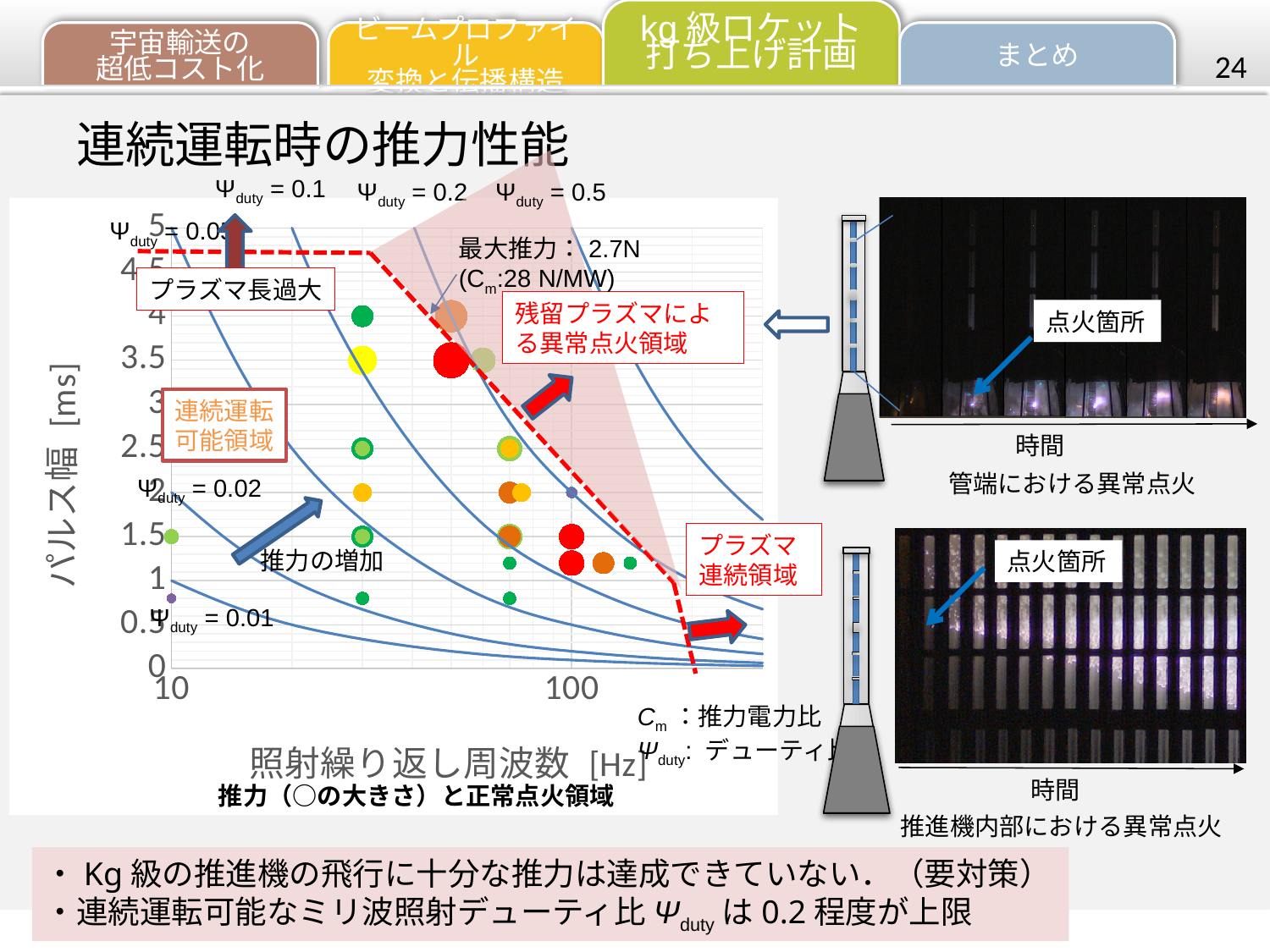
What is the smallest Ψduty value labelled on the chart? 0.01 What is the maximum thrust (最大推力) value annotated on the chart? 2.7N What is the largest Ψduty value labelled on the chart? 0.5 What kind of chart is shown on the slide? bubble (scatter) chart According to the chart caption, what does the size of each circle represent? 推力 What quantity is plotted on the x-axis of the chart? 照射繰り返し周波数 [Hz] What thrust-to-power ratio (Cm) is annotated next to the maximum thrust on the chart? 28 N/MW What is the highest tick value shown on the y-axis (パルス幅) of the chart? 5 How many different Ψduty values are labelled on the chart's curves? 6